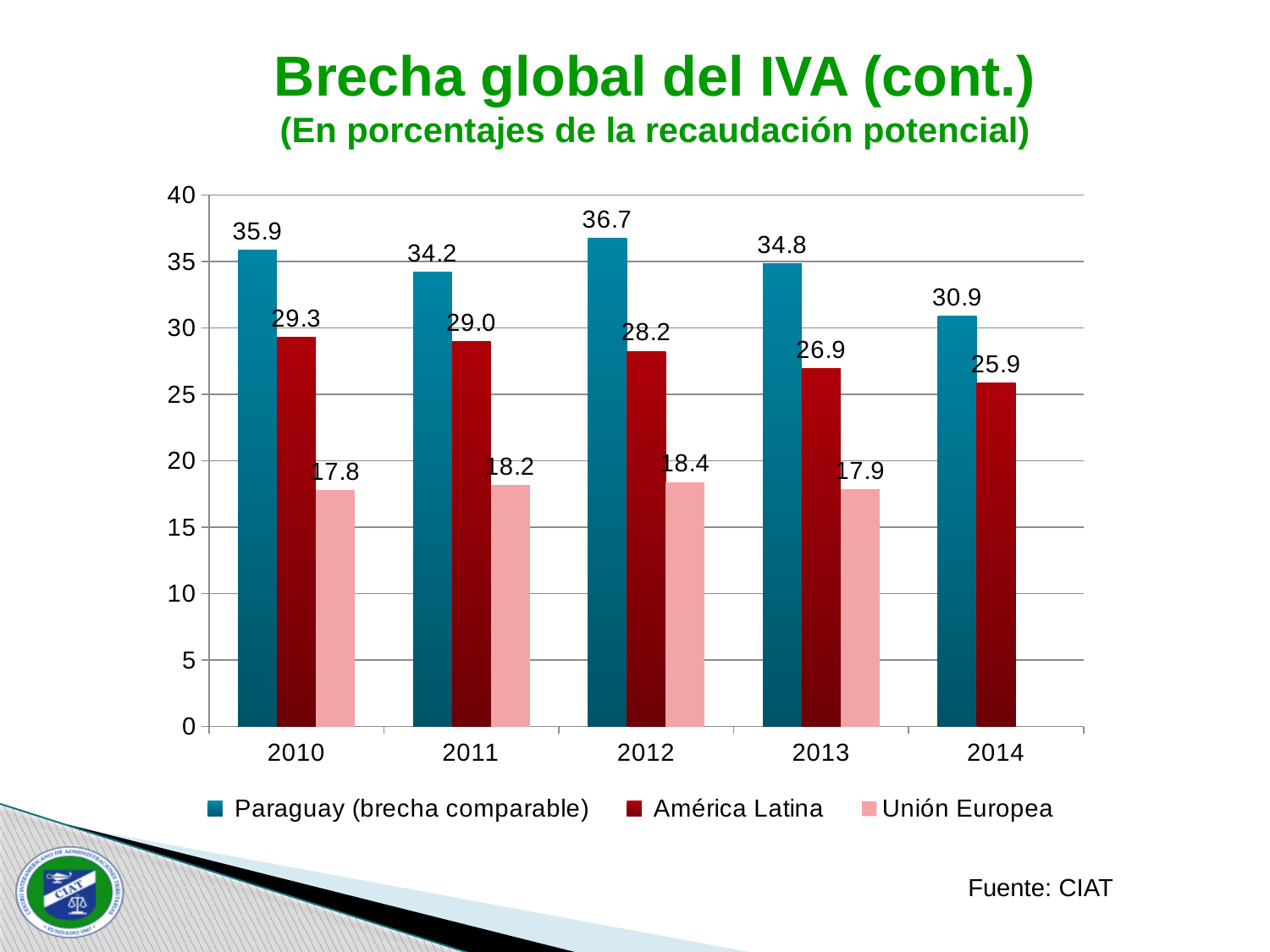
How many years are shown on the x axis? 5 In which year is the América Latina value lowest? 2014 Is the value for Unión Europea in 2012 greater or less than 20? less What kind of chart is shown on the slide? bar chart In which year is the Paraguay (brecha comparable) value highest? 2012 How many series does the legend list? 3 Does the América Latina value rise or fall from 2010 to 2014? fall What is the value for Paraguay (brecha comparable) in 2012? 36.7 Which is larger in 2014: the Paraguay (brecha comparable) value or the América Latina value? Paraguay (brecha comparable) What is the value for Unión Europea in 2011? 18.2 What is the value for América Latina in 2013? 26.9 What is the difference between the Paraguay (brecha comparable) value and the América Latina value in 2010? 6.6